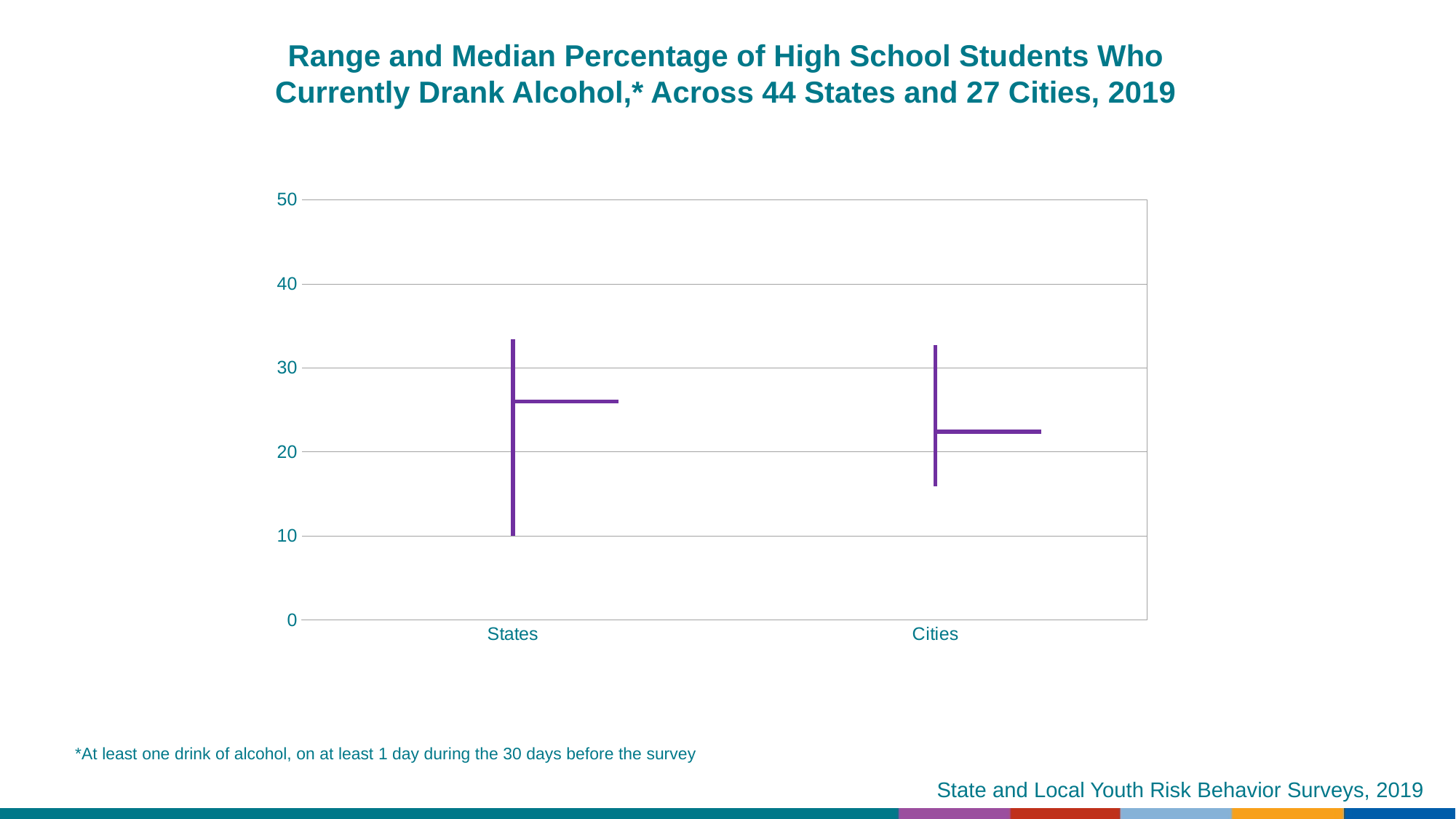
Is the median value for Cities greater or less than 20? greater Is the median value for States greater or less than 20? greater Is the median value for States greater or less than 30? less What is the highest value shown on the y axis of the chart? 50 What is the title of the chart? Range and Median Percentage of High School Students Who Currently Drank Alcohol,* Across 44 States and 27 Cities, 2019 Which category has the higher median percentage, States or Cities? States Does the median percentage rise or fall from States to Cities? fall Which category has the lower bottom of its range, States or Cities? States How many categories are shown on the x axis of the chart? 2